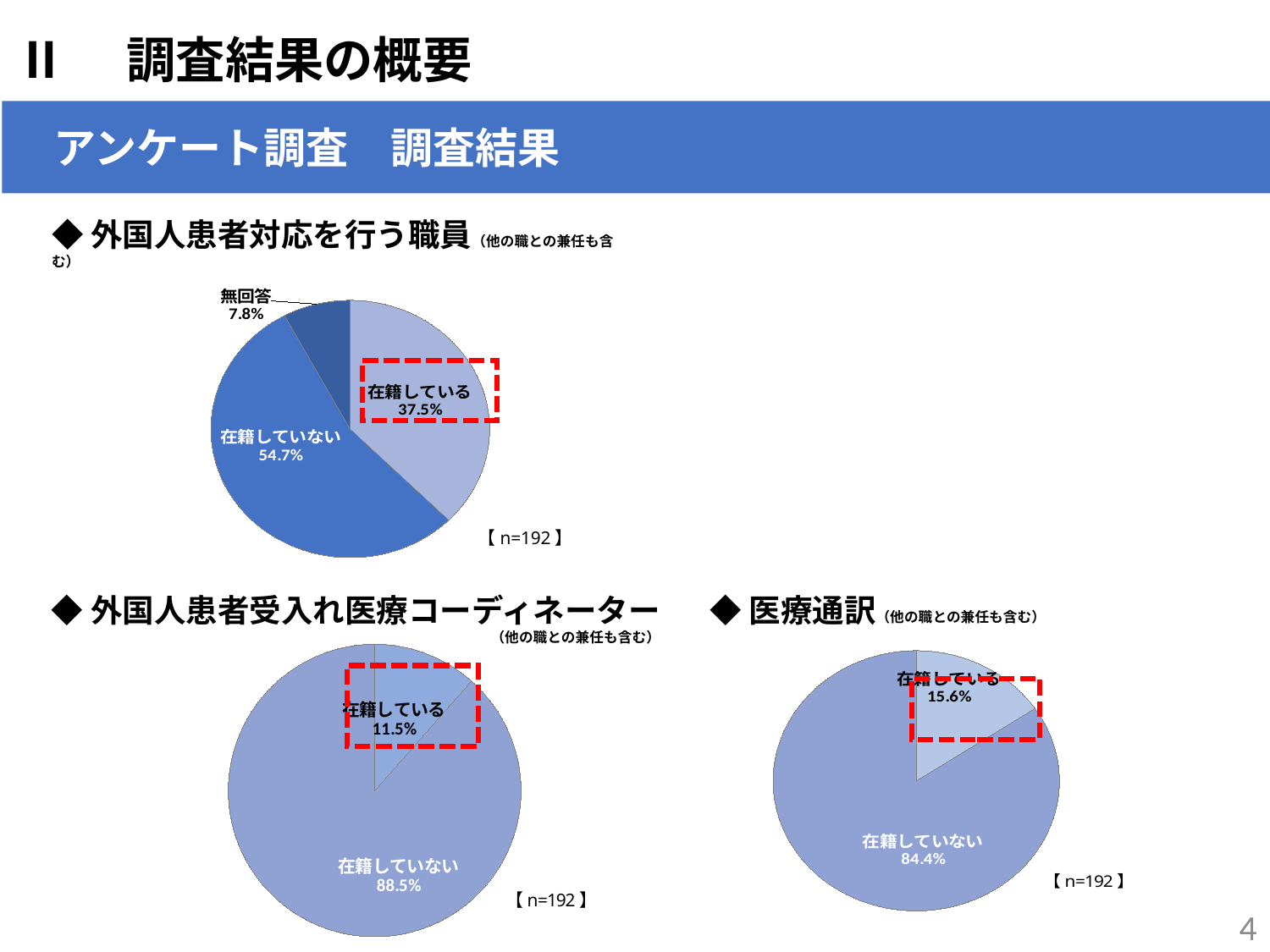
In the bottom-right pie chart (医療通訳), what percentage is shown for 在籍している? 15.6% In the top pie chart (外国人患者対応を行う職員), which slice is the smallest? 無回答 What sample size (n) is shown next to the top pie chart (外国人患者対応を行う職員)? n=192 In the top pie chart (外国人患者対応を行う職員), what is the difference between 在籍していない and 在籍している? 17.2% In the top pie chart (外国人患者対応を行う職員), what percentage is shown for 在籍している? 37.5% In the bottom-right pie chart (医療通訳), which is larger, 在籍している or 在籍していない? 在籍していない In the bottom-left pie chart (外国人患者受入れ医療コーディネーター), what percentage is shown for 在籍している? 11.5% In the top pie chart (外国人患者対応を行う職員), what percentage is shown for 無回答? 7.8% In the top pie chart (外国人患者対応を行う職員), how many slices does the pie have? 3 In the bottom-left pie chart (外国人患者受入れ医療コーディネーター), what percentage is shown for 在籍していない? 88.5% What kind of chart is used for 医療通訳 at the bottom right? Pie chart In the top pie chart (外国人患者対応を行う職員), which slice is the largest? 在籍していない